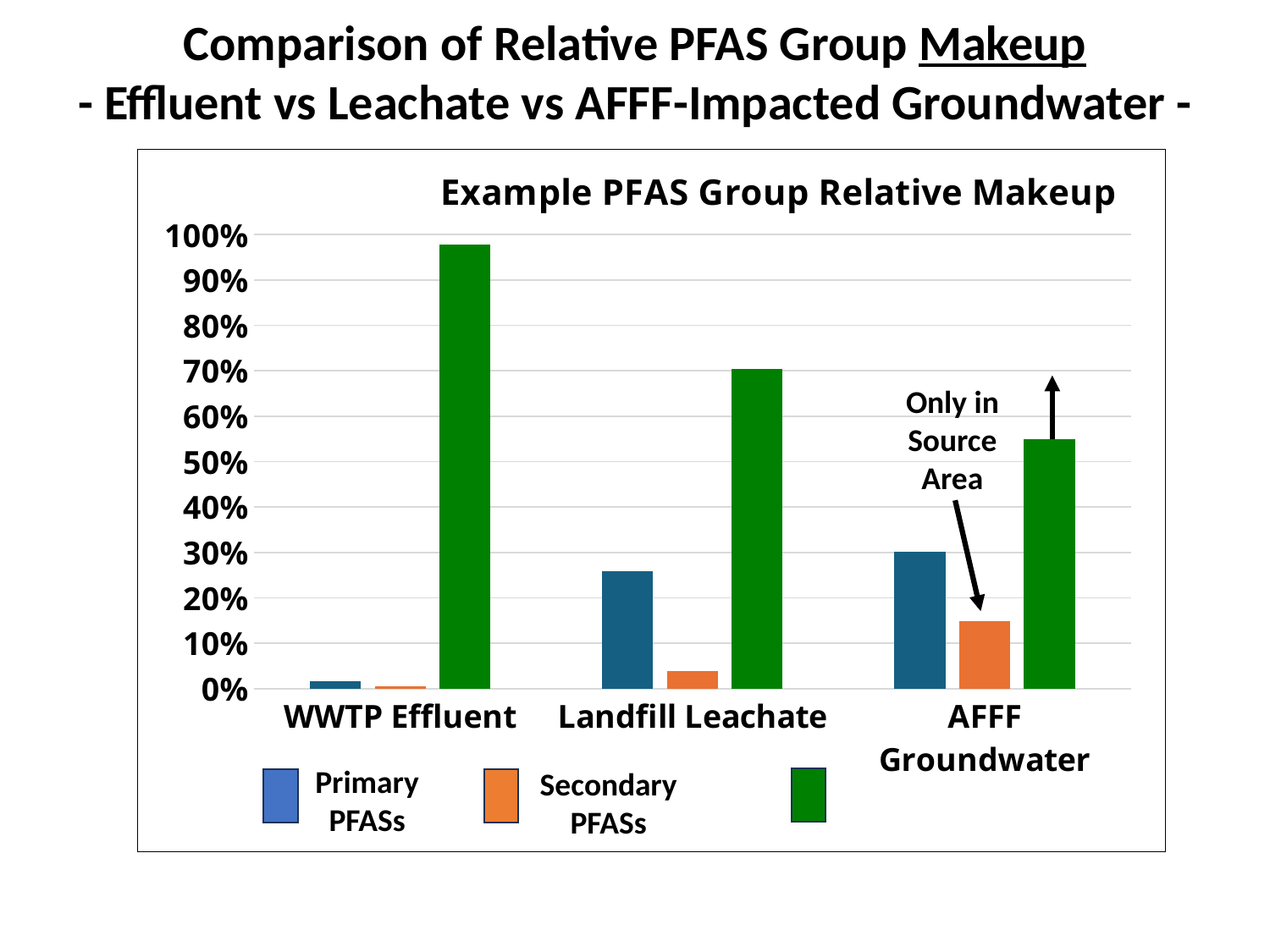
What is the title printed inside the chart area? Example PFAS Group Relative Makeup Which is larger: the Secondary PFASs value for AFFF Groundwater or for Landfill Leachate? AFFF Groundwater Which category has the tallest green bar? WWTP Effluent Which bar does the annotation "Only in Source Area" point to? Secondary PFASs bar for AFFF Groundwater What kind of chart is shown on the slide? bar chart Is the Primary PFASs value for Landfill Leachate greater or less than 20%? greater How many categories are shown on the x axis of the chart? 3 Is the green bar for WWTP Effluent greater or less than 90%? greater How many series does the chart's legend list? 3 Is the green bar for AFFF Groundwater greater or less than 50%? greater Which category has the lowest Primary PFASs value? WWTP Effluent